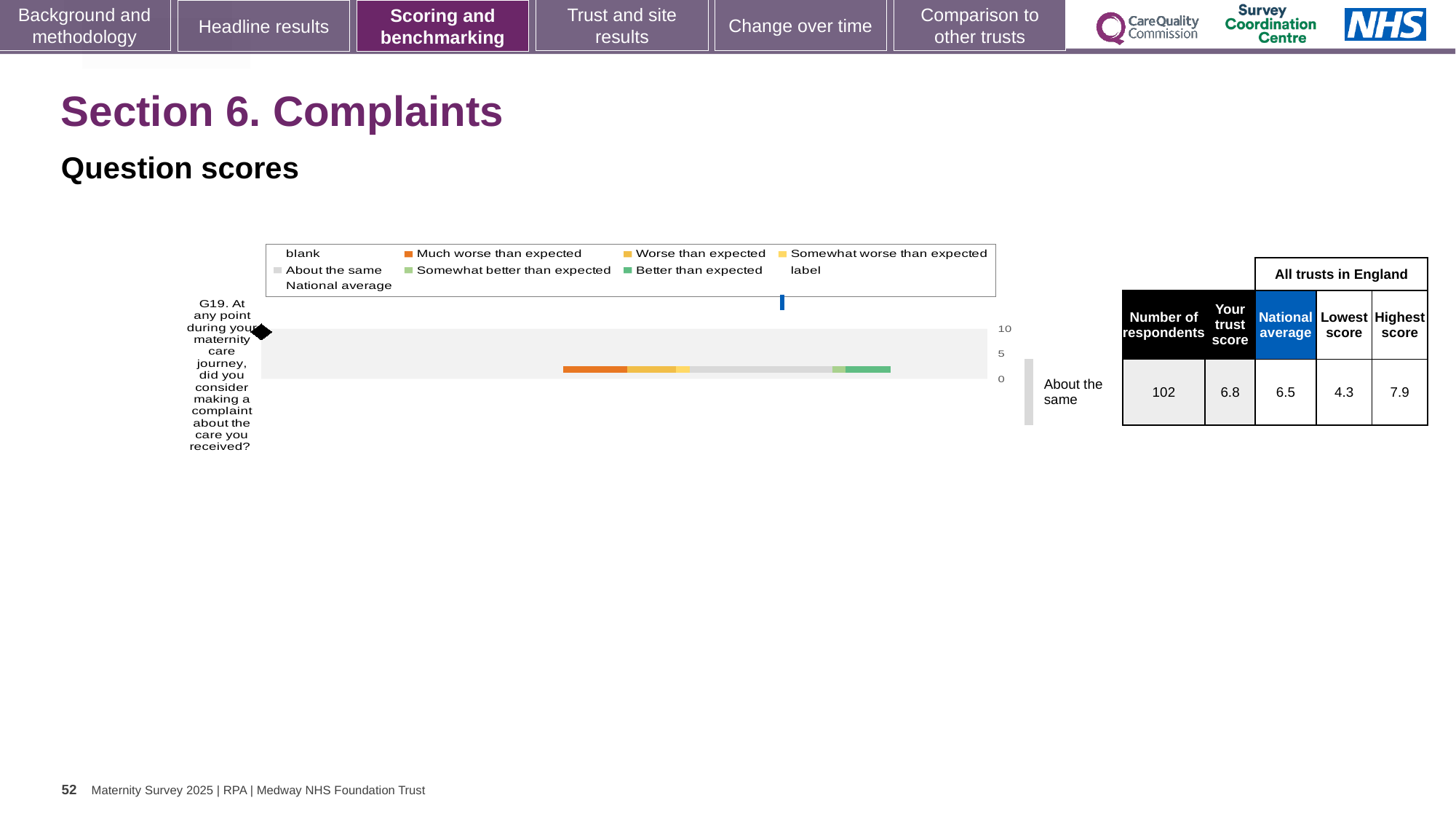
Which legend entry is shown in orange? Much worse than expected What benchmark category is shown next to the chart for question G19? About the same What kind of chart is shown on the slide? bar chart What is the highest score among all trusts in England for question G19? 7.9 How many respondents are shown for question G19? 102 Which is larger for question G19, the trust score or the national average? the trust score What is the trust score shown for question G19? 6.8 How many questions (categories) are plotted in the chart? 1 What is the national average shown for question G19? 6.5 What is the highest value shown on the chart's axis? 10 What is the lowest score among all trusts in England for question G19? 4.3 Is the national average marker on the chart greater or less than 5? greater